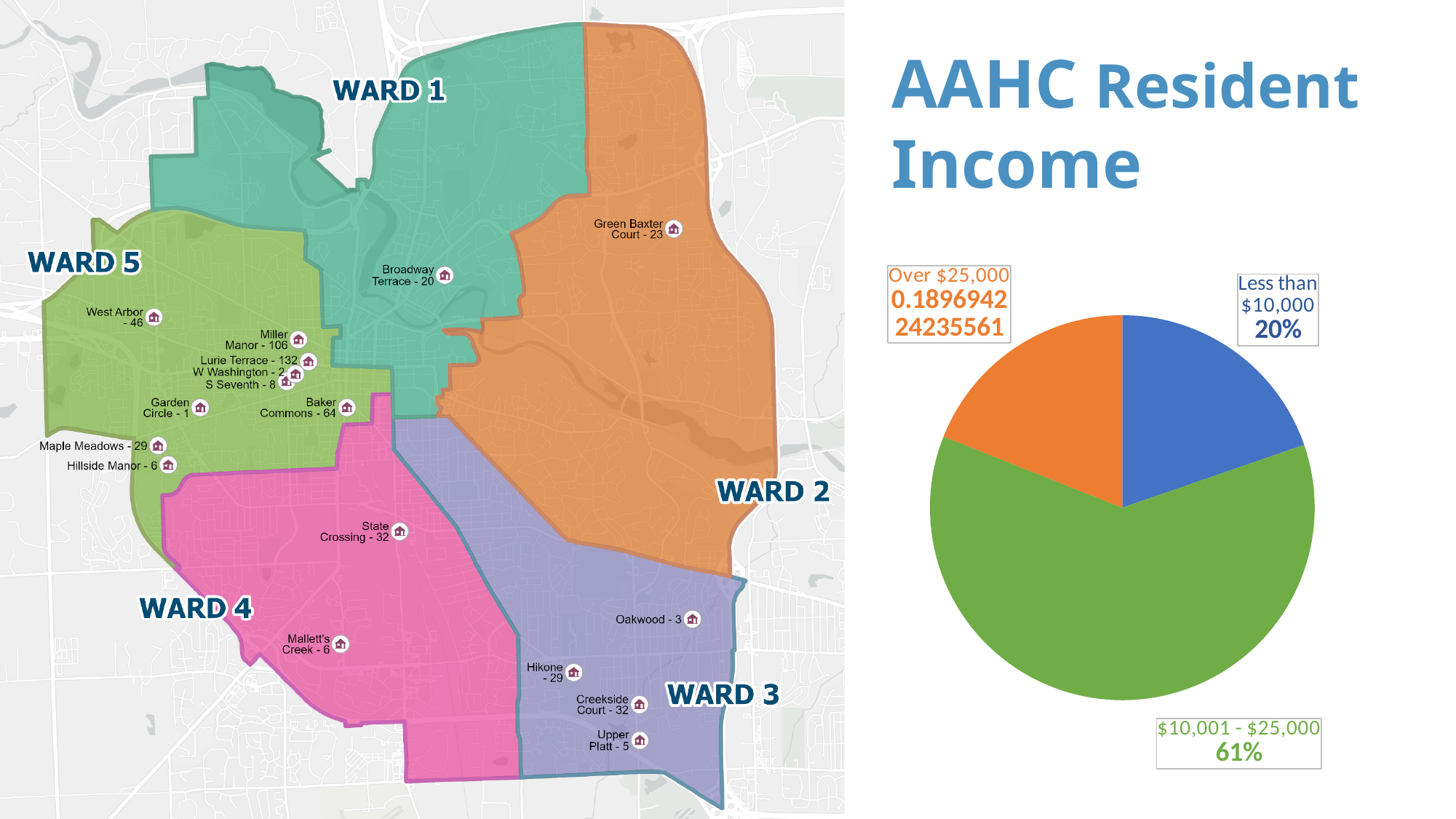
Which income category has the largest slice in the AAHC Resident Income pie chart? $10,001 - $25,000 In the AAHC Resident Income pie chart, which is larger: the Less than $10,000 slice or the $10,001 - $25,000 slice? $10,001 - $25,000 What share of the AAHC Resident Income pie does the $10,001 - $25,000 slice represent? 61% In the AAHC Resident Income pie chart, how many percentage points larger is the $10,001 - $25,000 share than the Less than $10,000 share? 41 percentage points In the AAHC Resident Income pie chart, what share of residents have income of less than $10,000? 20% In the AAHC Resident Income pie chart, what share of residents have income of $10,001 - $25,000? 61% What is the title of the pie chart on the slide? AAHC Resident Income What colour is the $10,001 - $25,000 slice in the AAHC Resident Income pie chart? green What kind of chart is the AAHC Resident Income chart? pie chart How many slices does the AAHC Resident Income pie chart have? 3 In the AAHC Resident Income pie chart, what value is printed for the Over $25,000 slice? 0.189694224235561